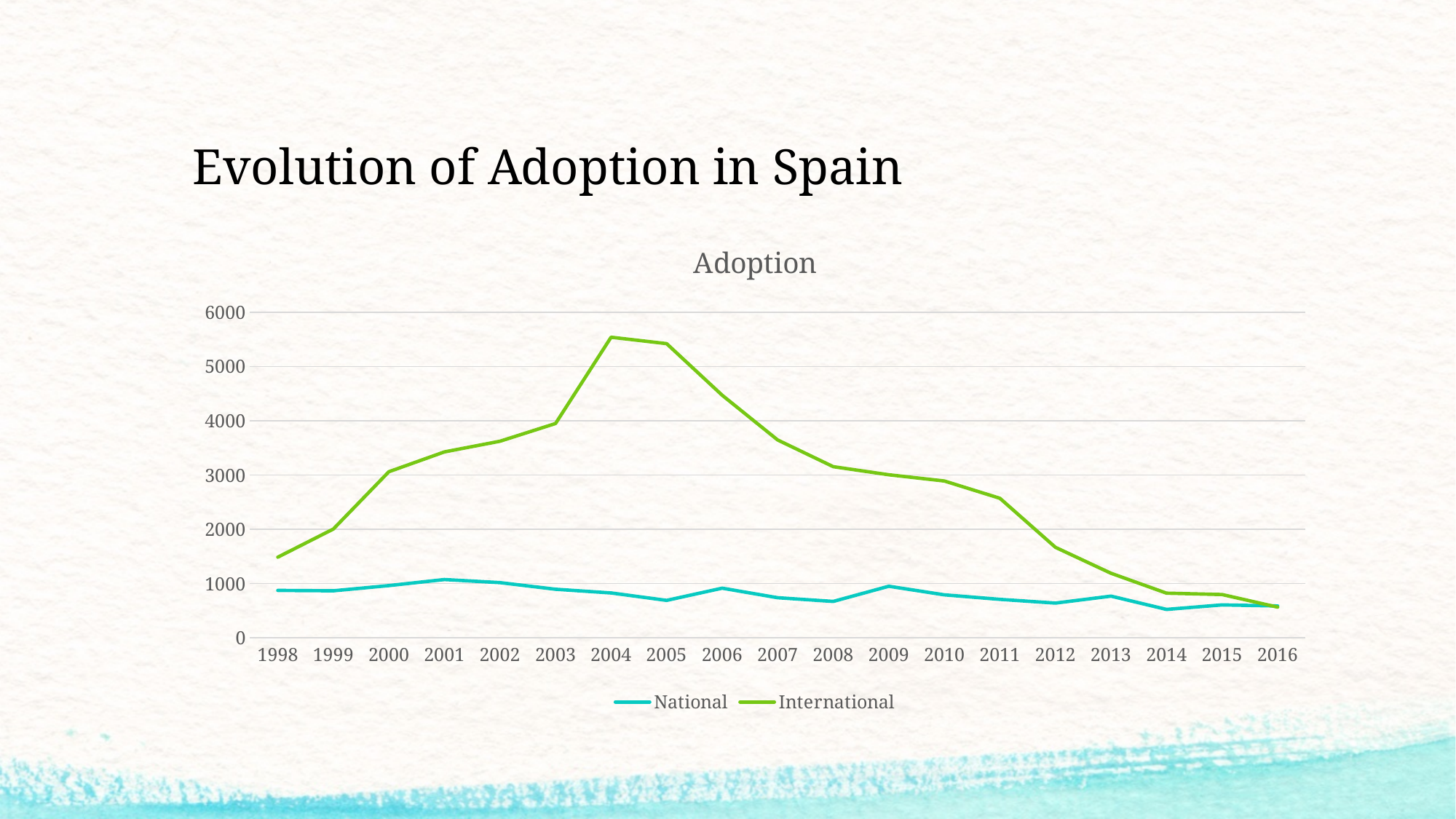
Is the International value for 2008 greater or less than 3000? greater In which year does the National series reach its highest value? 2001 Does the International series rise or fall from 2005 to 2016? fall How many series does the legend list? 2 Which series has the larger value in 2010, National or International? International Is the International value for 2004 greater or less than 5000? greater What kind of chart is shown on the slide? line chart How many years are plotted along the x axis? 19 Is the International value for 2012 greater or less than 2000? less In which year does the International series reach its lowest value? 2016 In which year does the International series reach its highest value? 2004